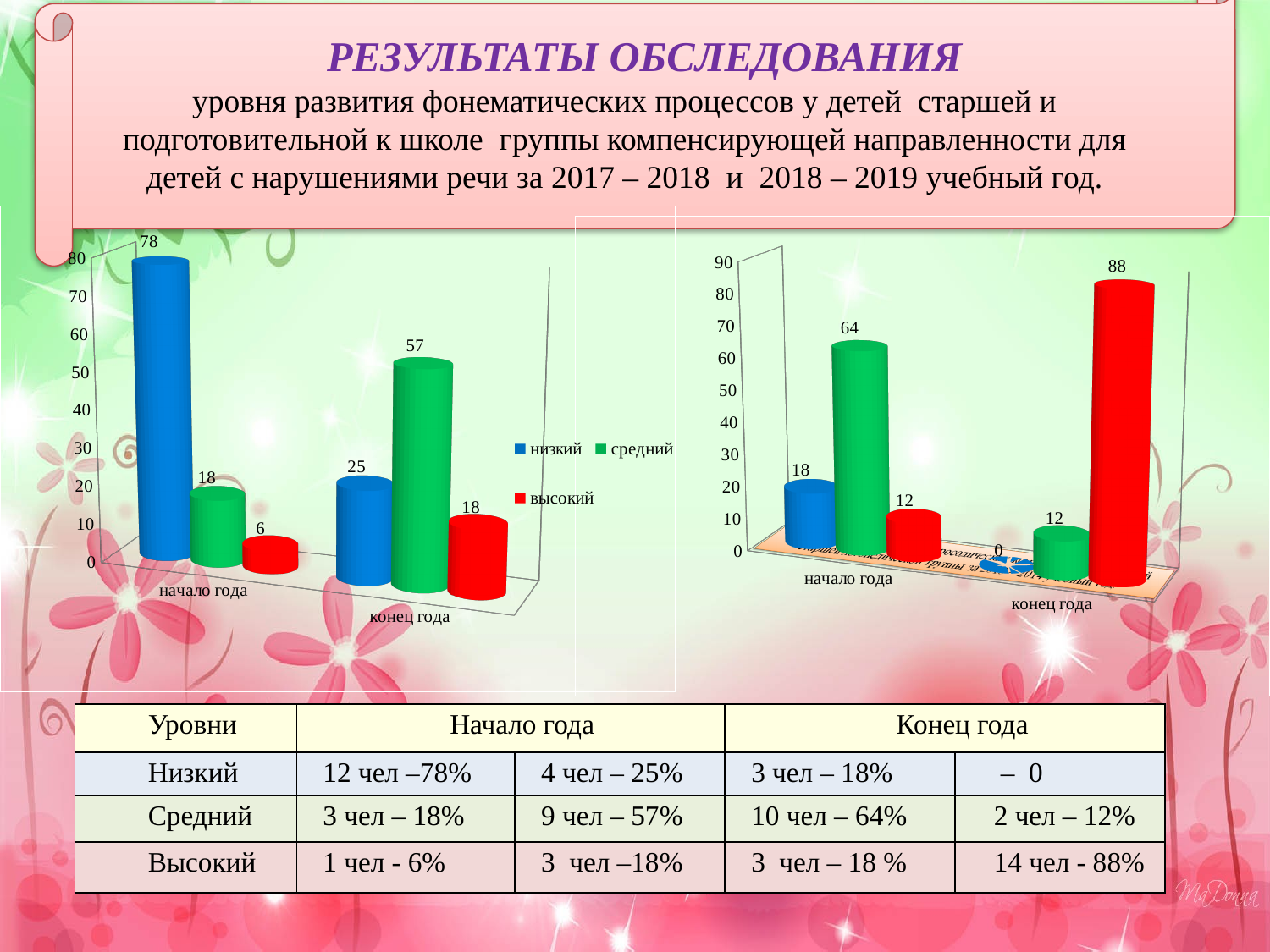
In the right chart, which bar is the highest at конец года? the red bar (высокий) In the left chart, what type of chart is shown? bar chart In the left chart, what is the value for низкий at начало года? 78 In the right chart, what is the value of the red bar at конец года? 88 In the right chart, how many categories are shown on the x axis? 2 In the right chart, what is the value of the green bar at начало года? 64 In the right chart, is the green bar at начало года larger or smaller than the red bar at начало года? larger In the left chart, which series has the lowest value at начало года? высокий In the left chart, how many series does the legend list? 3 In the right chart, what is the value of the blue bar at конец года? 0 In the left chart, what is the difference between the низкий values at начало года and конец года? 53 In the left chart, what is the value for средний at конец года? 57